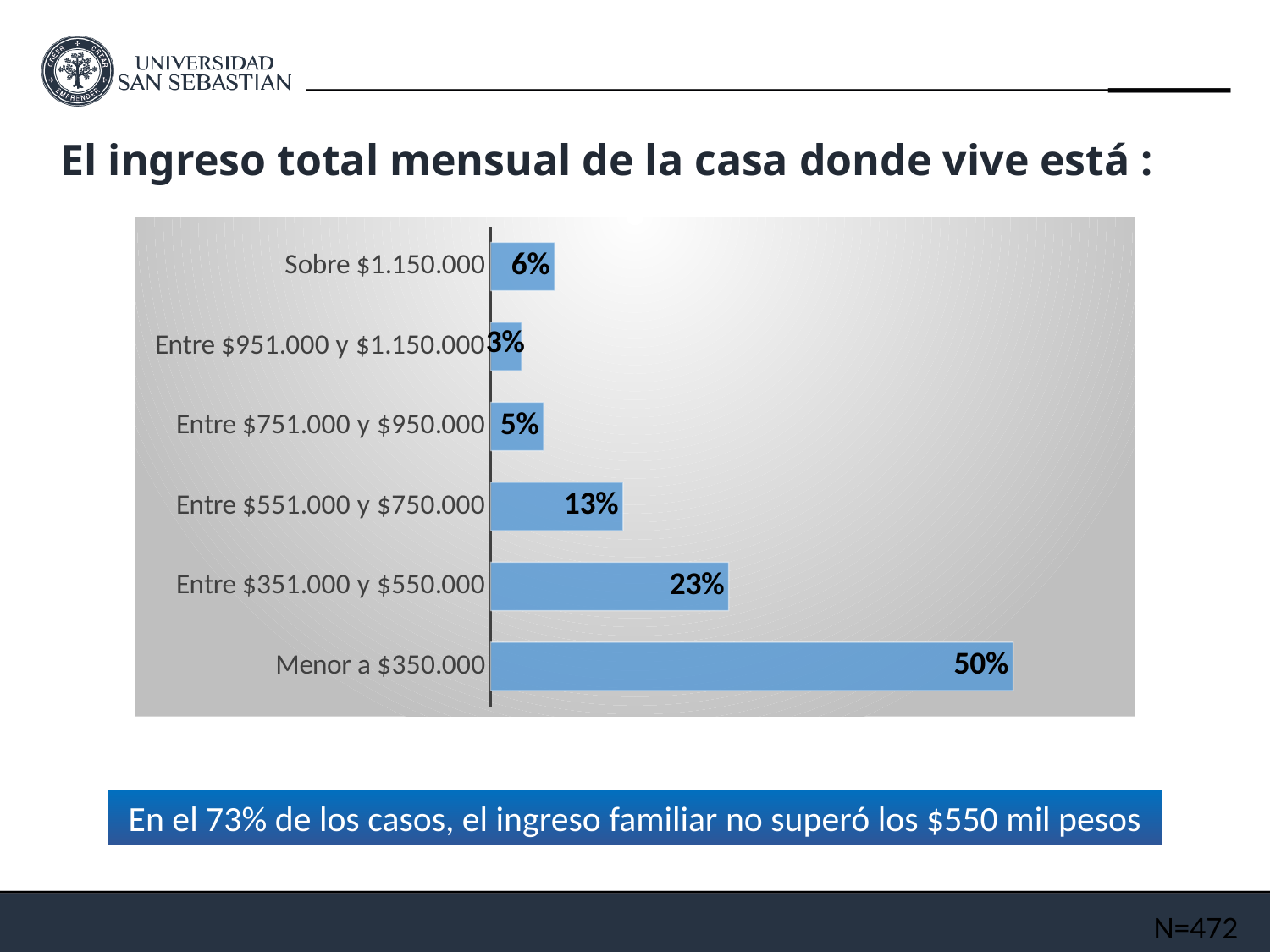
What is the difference between the values for "Entre $551.000 y $750.000" and "Entre $751.000 y $950.000"? 8% What is the value for "Sobre $1.150.000"? 6% What is the title of the slide above the chart? El ingreso total mensual de la casa donde vive está : What is the difference between the values for "Menor a $350.000" and "Entre $351.000 y $550.000"? 27% Which category has the lowest value? Entre $951.000 y $1.150.000 Which category has the highest value? Menor a $350.000 What is the value for "Entre $551.000 y $750.000"? 13% What is the combined value of "Menor a $350.000" and "Entre $351.000 y $550.000"? 73% Which is larger, the value for "Sobre $1.150.000" or the value for "Entre $751.000 y $950.000"? Sobre $1.150.000 What kind of chart is shown on the slide? Bar chart How many categories are shown in the chart? 6 What is the value for "Menor a $350.000"? 50%